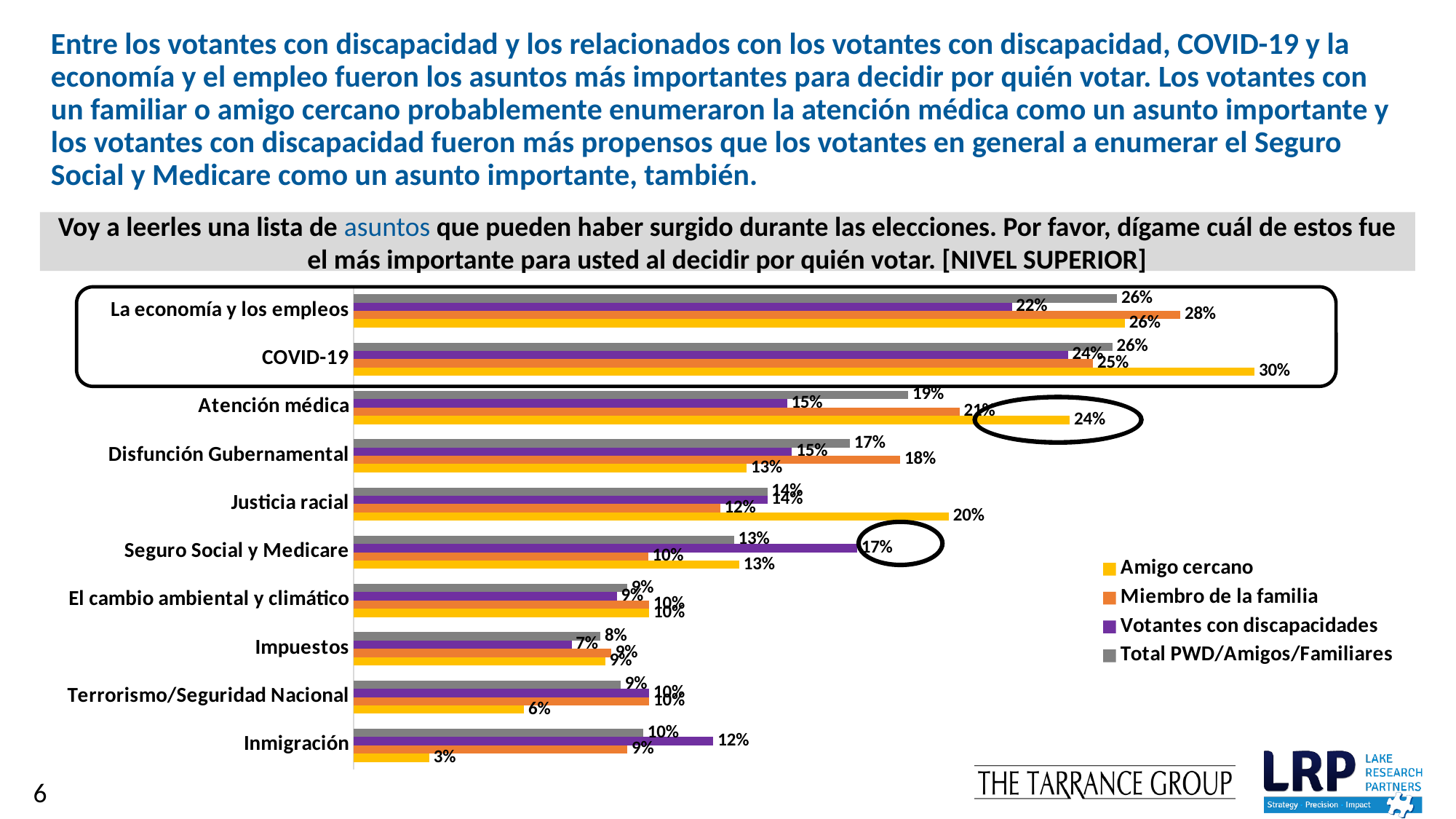
What is the value for Amigo cercano for COVID-19? 30% What is the value for Total PWD/Amigos/Familiares for Atención médica? 19% Which series is shown in yellow in the legend? Amigo cercano For Inmigración, which is larger: the value for Votantes con discapacidades or the value for Amigo cercano? Votantes con discapacidades What kind of chart is shown on the slide? bar chart How many issue categories are plotted on the chart? 10 What is the value for Votantes con discapacidades for Seguro Social y Medicare? 17% What is the difference between the Amigo cercano value and the Miembro de la familia value for Justicia racial? 8% What is the value for Miembro de la familia for La economía y los empleos? 28% Which category has the lowest value for Amigo cercano? Inmigración How many series does the legend list? 4 Which category has the highest value for Votantes con discapacidades? COVID-19